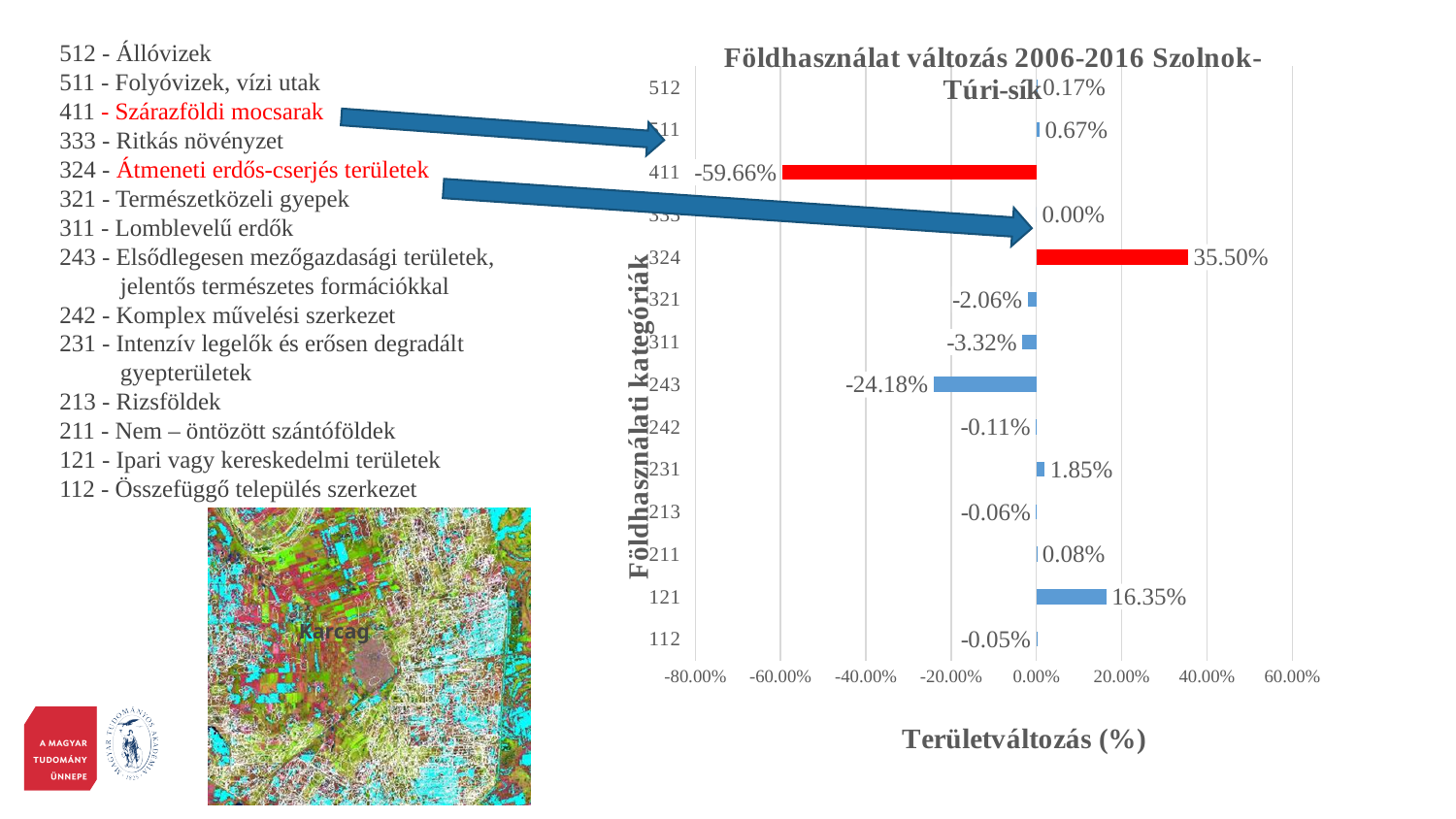
What is the value for category 333 in the chart? 0.00% What is the title of the chart's horizontal axis? Területváltozás (%) How many categories are shown on the chart's vertical axis? 14 What is the value for category 411 in the chart? -59.66% Which category has the lowest value in the chart? 411 What is the value for category 324 in the chart? 35.50% Which category has the highest value in the chart? 324 What is the value for category 243 in the chart? -24.18% Which has a larger value, category 231 or category 311? 231 What kind of chart is shown on the slide? Bar chart What is the value for category 121 in the chart? 16.35% What is the difference between the values for categories 324 and 121? 19.15%